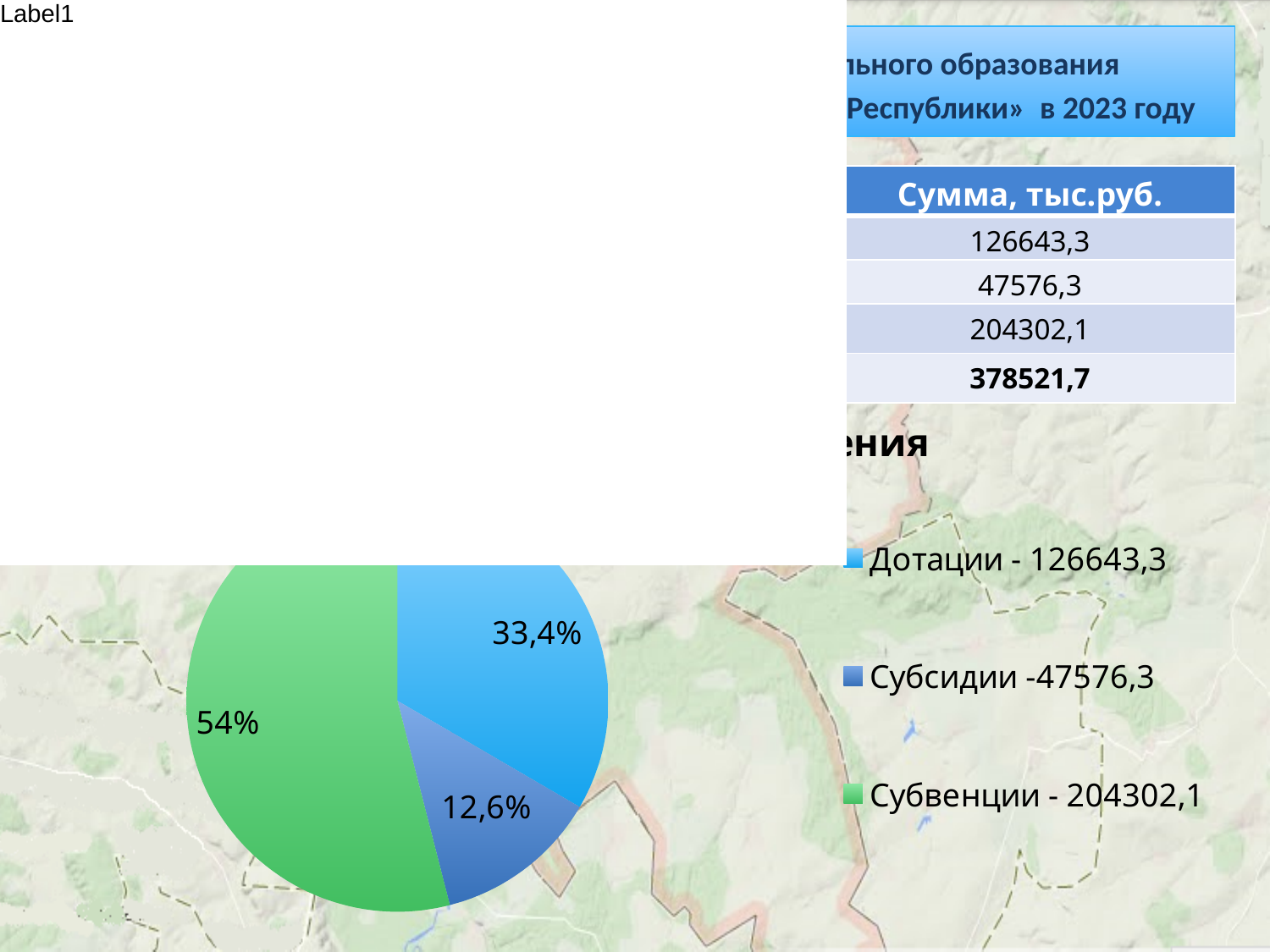
What is the difference in percentage points between the Субвенции slice and the Дотации slice? 20,6% Which category has the largest slice of the pie? Субвенции Which category has the smallest slice of the pie? Субсидии How many entries does the legend of the pie chart list? 3 How many slices does the pie chart have? 3 What share of the pie does Субсидии have? 12,6% According to the legend, what amount is given for Субсидии? 47576,3 What colour is the Субвенции slice of the pie chart? green What kind of chart is shown on the slide? pie chart Which is larger, the slice for Дотации or the slice for Субсидии? Дотации What share of the pie does Дотации have? 33,4% What share of the pie does Субвенции have? 54%